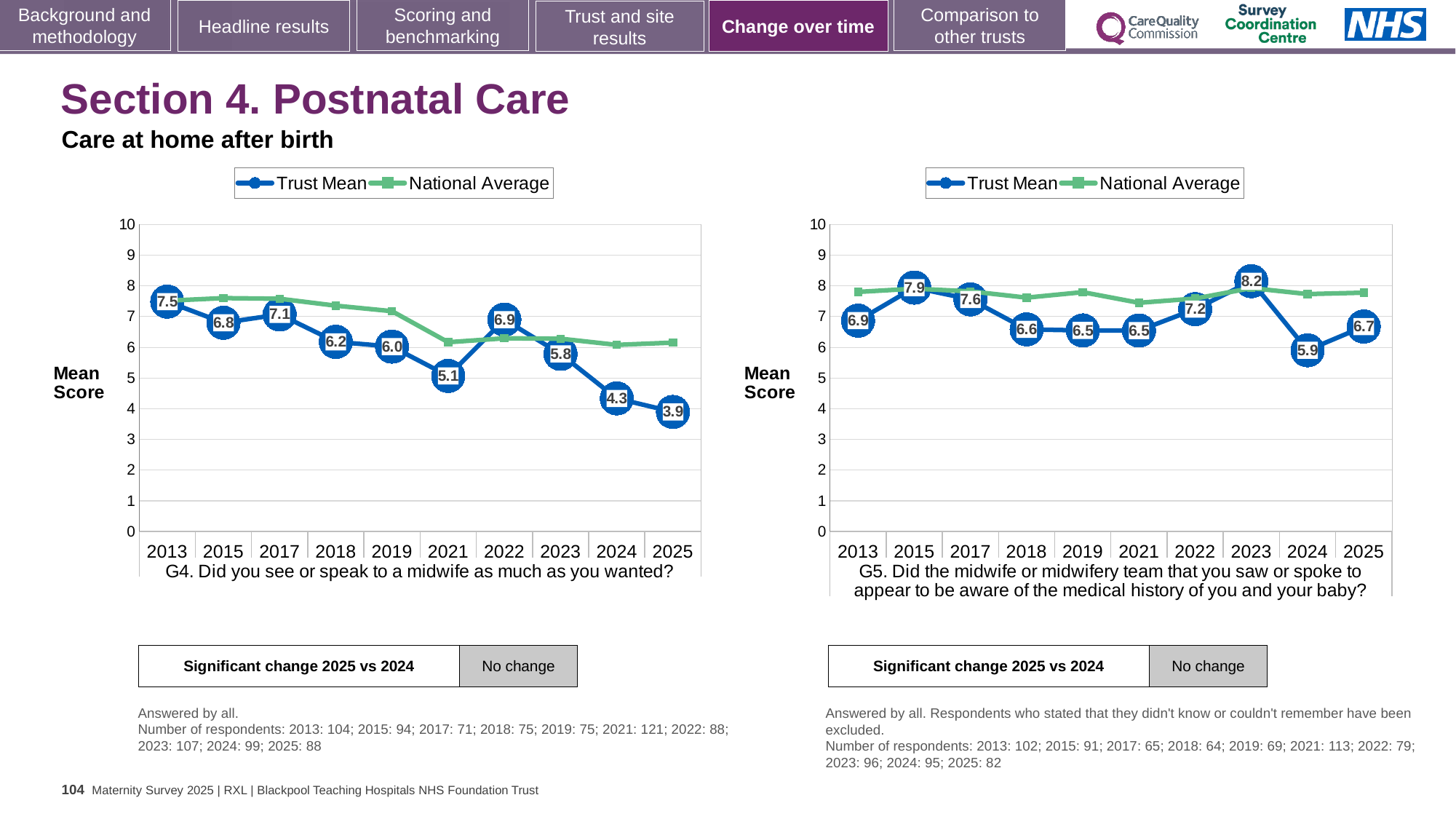
In the G5 chart (right), what is the Trust Mean score for 2023? 8.2 In the G4 chart (left), what is the difference between the Trust Mean scores for 2022 and 2021? 1.8 In the G4 chart (left), what is the Trust Mean score for 2025? 3.9 In the G4 chart (left), how many years are shown on the x axis? 10 In the G4 chart (left), what is the Trust Mean score for 2013? 7.5 In the G5 chart (right), which year has the lowest Trust Mean score? 2024 In the G4 chart (left), is the National Average for 2025 greater or less than 5? greater In the G4 chart (left), which year has the lowest Trust Mean score? 2025 In the G5 chart (right), which is larger, the Trust Mean for 2015 or the Trust Mean for 2018? 2015 In the G5 chart (right), how many series does the legend list? 2 In the G5 chart (right), which year has the highest Trust Mean score? 2023 What type of chart is the G4 chart (left)? Line chart